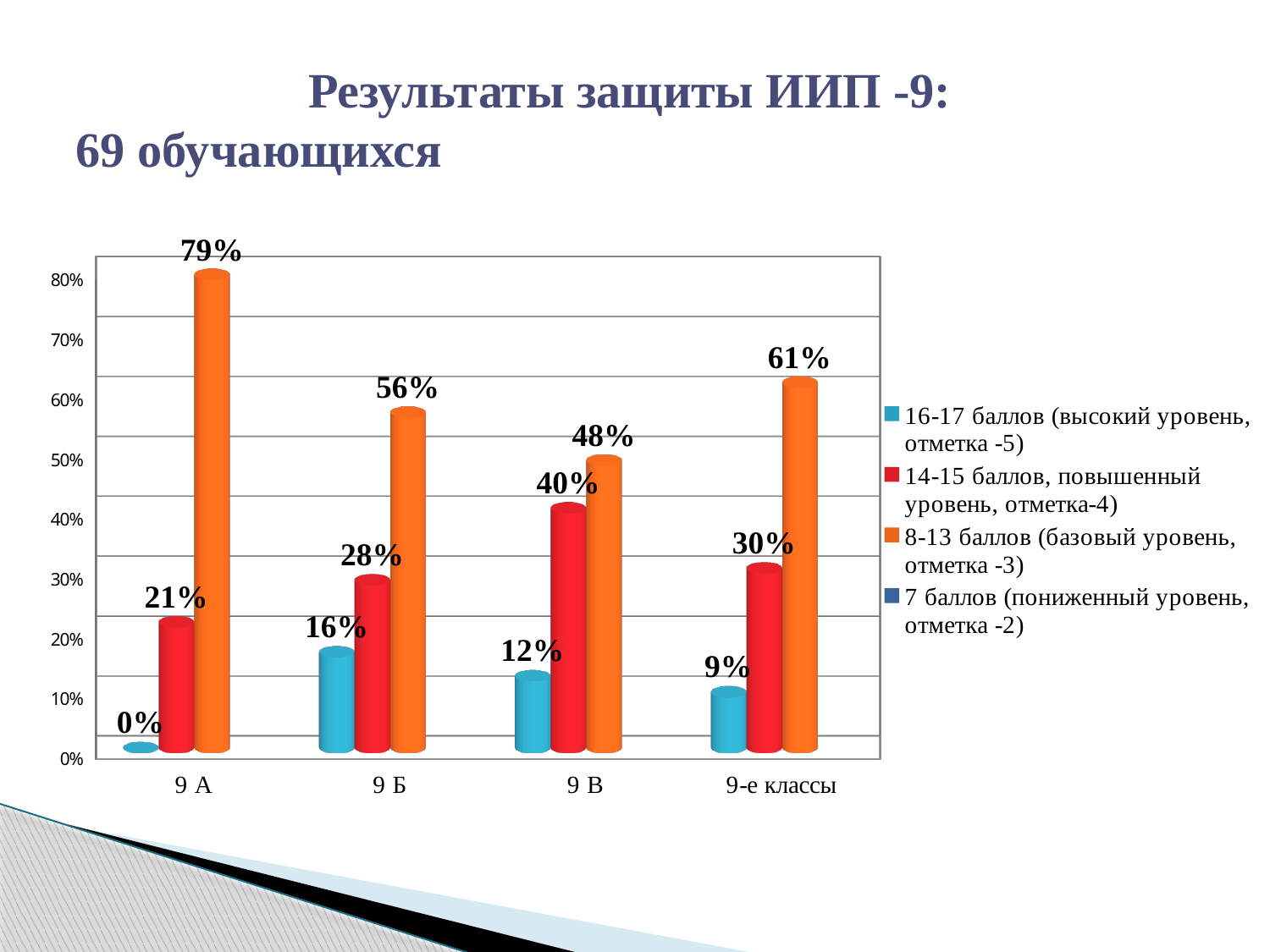
Which category has the lowest value in the series "16-17 баллов (высокий уровень, отметка -5)"? 9 А How many categories are shown on the x axis? 4 What is the value for 9 А in the series "8-13 баллов (базовый уровень, отметка -3)"? 79% How many series does the legend list? 4 What is the value for 9 Б in the series "16-17 баллов (высокий уровень, отметка -5)"? 16% What kind of chart is shown on the slide? bar chart Which is larger: the "14-15 баллов" value for 9 В or for 9-е классы? 9 В Is the "8-13 баллов" value for 9 В greater or less than 50%? less What is the value for 9 В in the series "14-15 баллов, повышенный уровень, отметка-4"? 40% What is the difference between the "8-13 баллов" values for 9 А and 9 Б? 23% What is the value for 9-е классы in the series "8-13 баллов (базовый уровень, отметка -3)"? 61% Which category has the highest value in the series "8-13 баллов (базовый уровень, отметка -3)"? 9 А